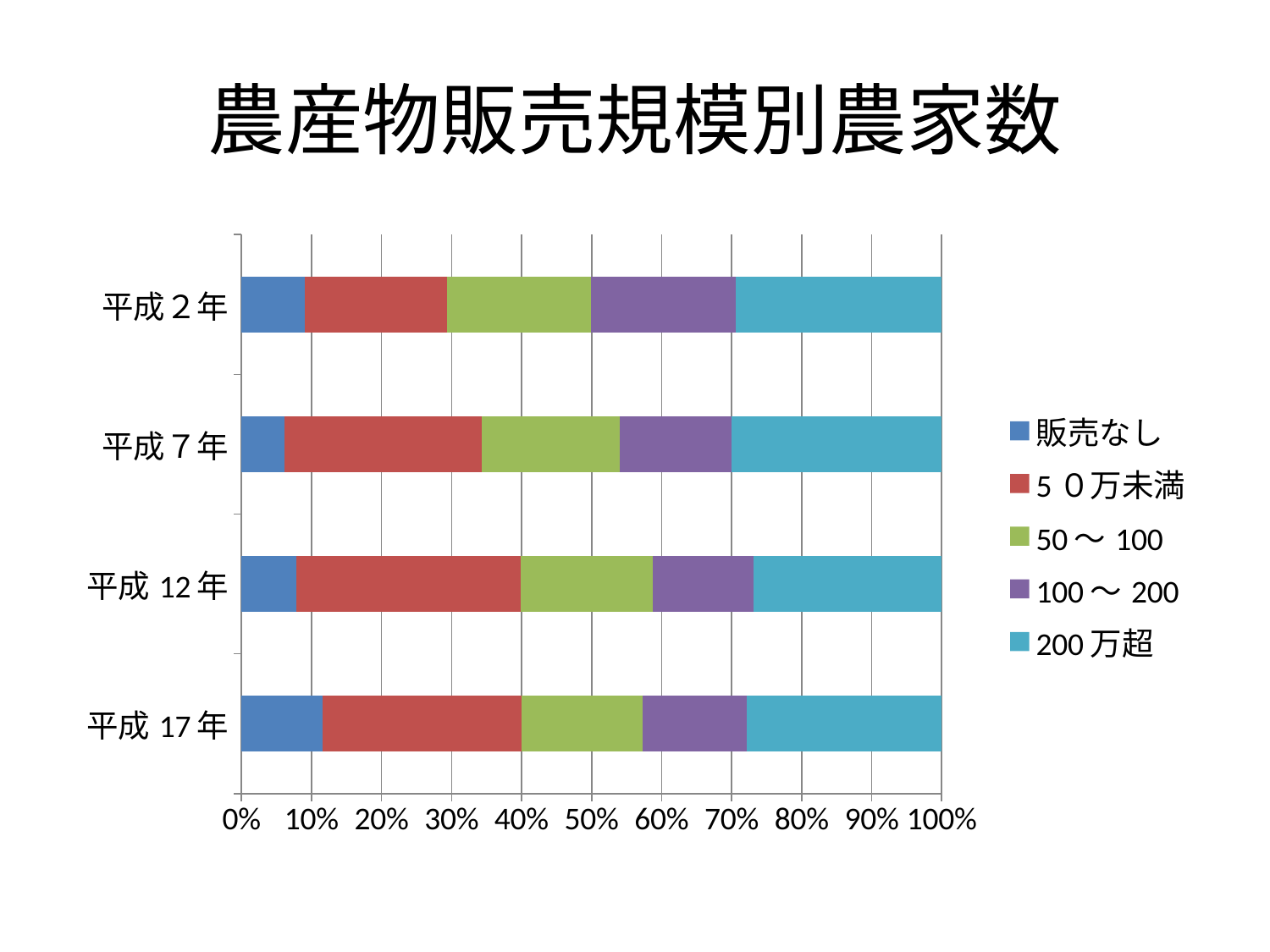
What is the title of the chart? 農産物販売規模別農家数 Which year has the largest 販売なし segment? 平成17年 Is the 50万未満 segment larger for 平成12年 or 平成2年? 平成12年 Is the 販売なし share for 平成7年 greater or less than 10%? less Which legend entry is shown in blue (the first entry)? 販売なし How many series does the legend list? 5 Is the 販売なし share for 平成17年 greater or less than 10%? greater Is the 販売なし segment larger for 平成17年 or 平成7年? 平成17年 What is the maximum value shown on the horizontal axis? 100% How many years (categories) are shown on the chart? 4 What kind of chart is shown on the slide? stacked bar chart